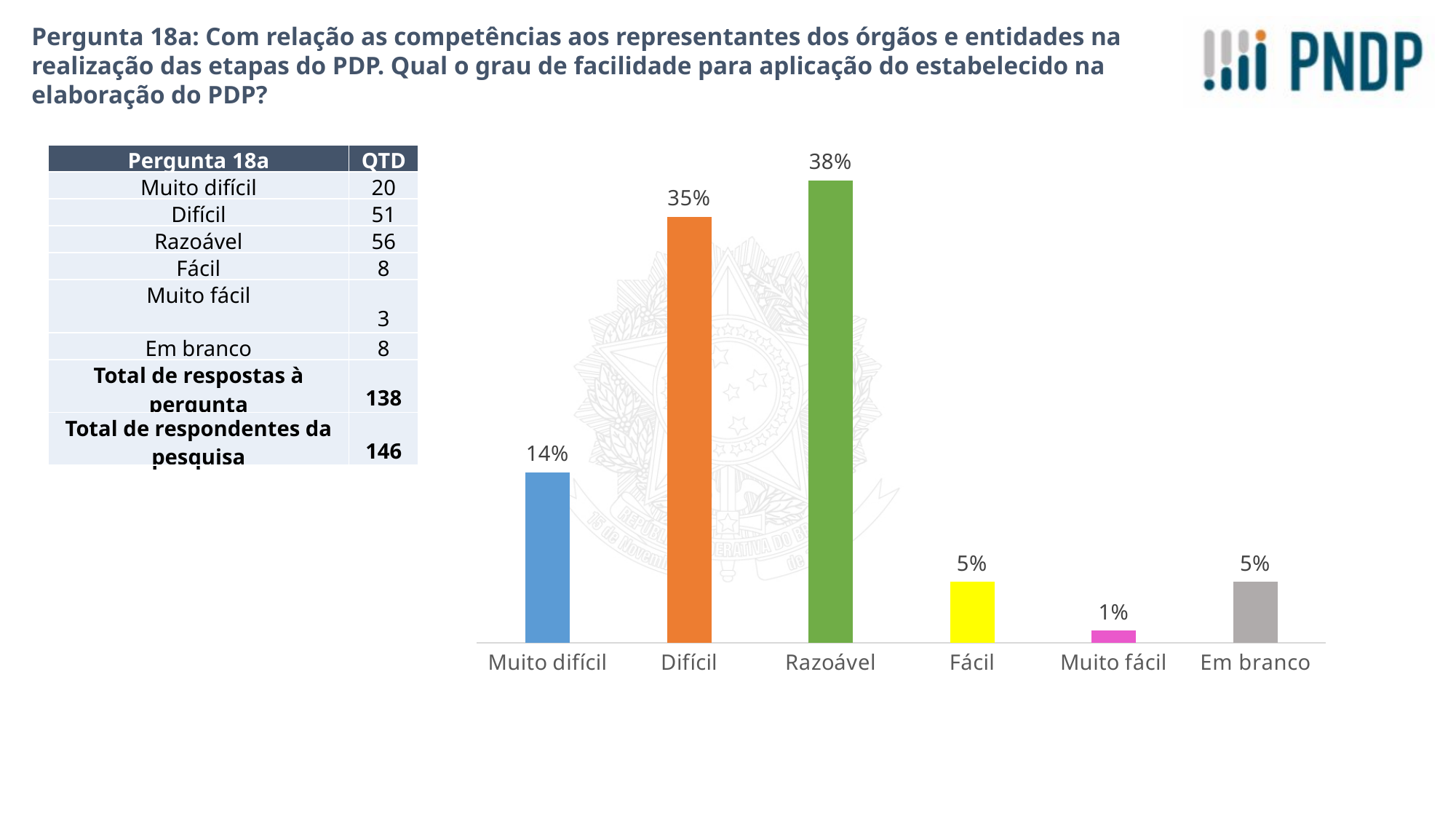
What percentage is shown for Razoável in the bar chart? 38% Which is larger, the value for Difícil or the value for Muito difícil? Difícil What is the difference in percentage points between Razoável and Difícil? 3 What type of chart is shown on the slide? Bar chart What is the difference in percentage points between Difícil and Muito difícil? 21 Which category has the lowest bar in the chart? Muito fácil How many categories are shown on the x axis of the bar chart? 6 Which category has the highest bar in the chart? Razoável What colour is the bar for Razoável? Green Which is larger, the value for Fácil or the value for Muito fácil? Fácil What percentage is shown for Muito difícil in the bar chart? 14% What percentage is shown for Muito fácil in the bar chart? 1%